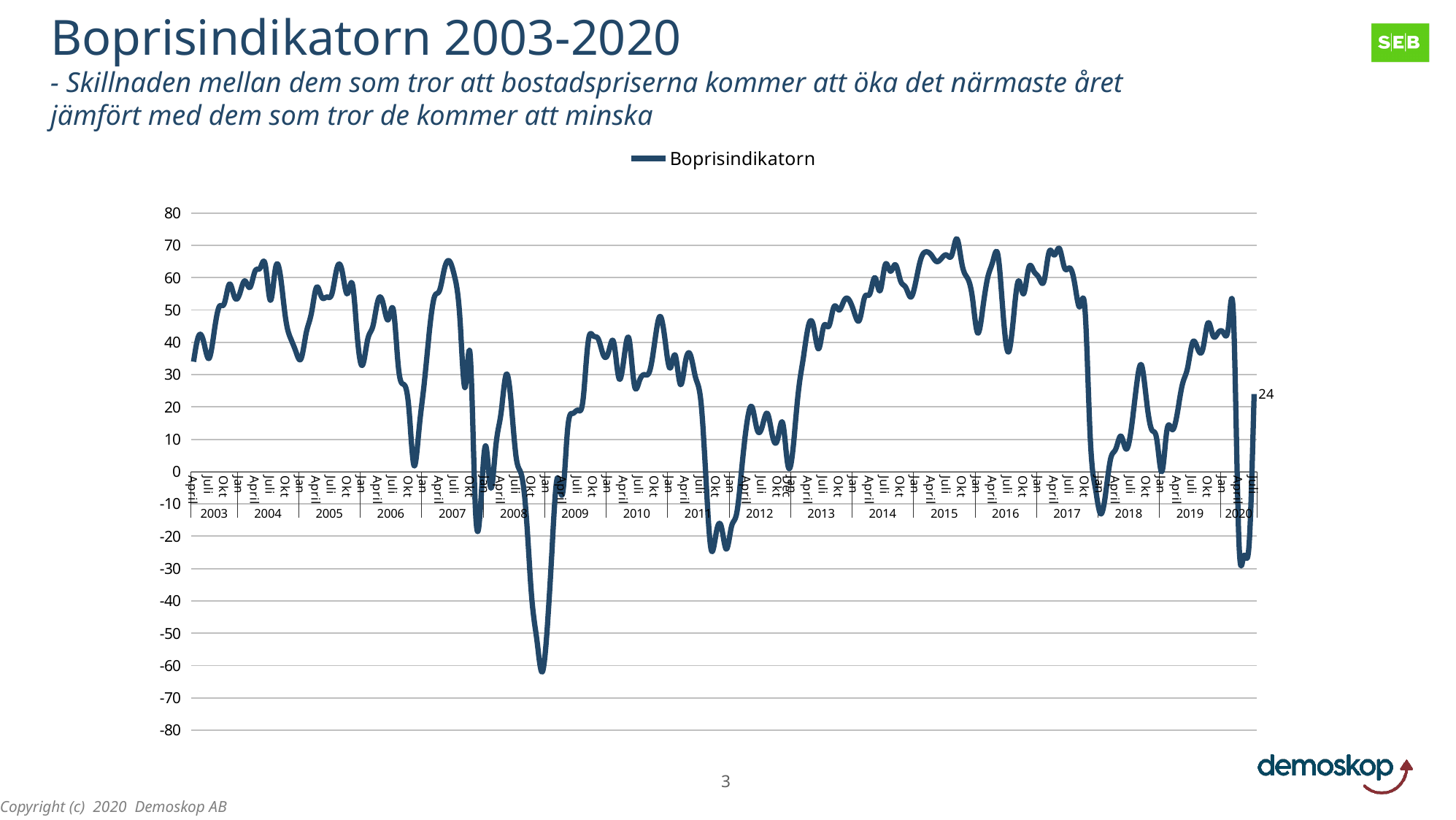
Which is higher, the value of the line around Okt 2015 or the value around Jan 2009? Okt 2015 Does the line rise or fall between April 2020 and Juli 2020? rise Is the value of the line around Jan 2018 greater or less than 0? less What is the highest value shown on the y axis? 80 Is the lowest value of the line (around Jan 2009) greater or less than -50? less What is the value printed at the last data point of the line (Juli 2020)? 24 How many series does the legend list? 1 Is the value at the start of the line (April 2003) greater or less than 20? greater What is the name of the series shown in the legend? Boprisindikatorn How many years are labelled along the x axis? 18 What kind of chart is shown on the slide? line chart